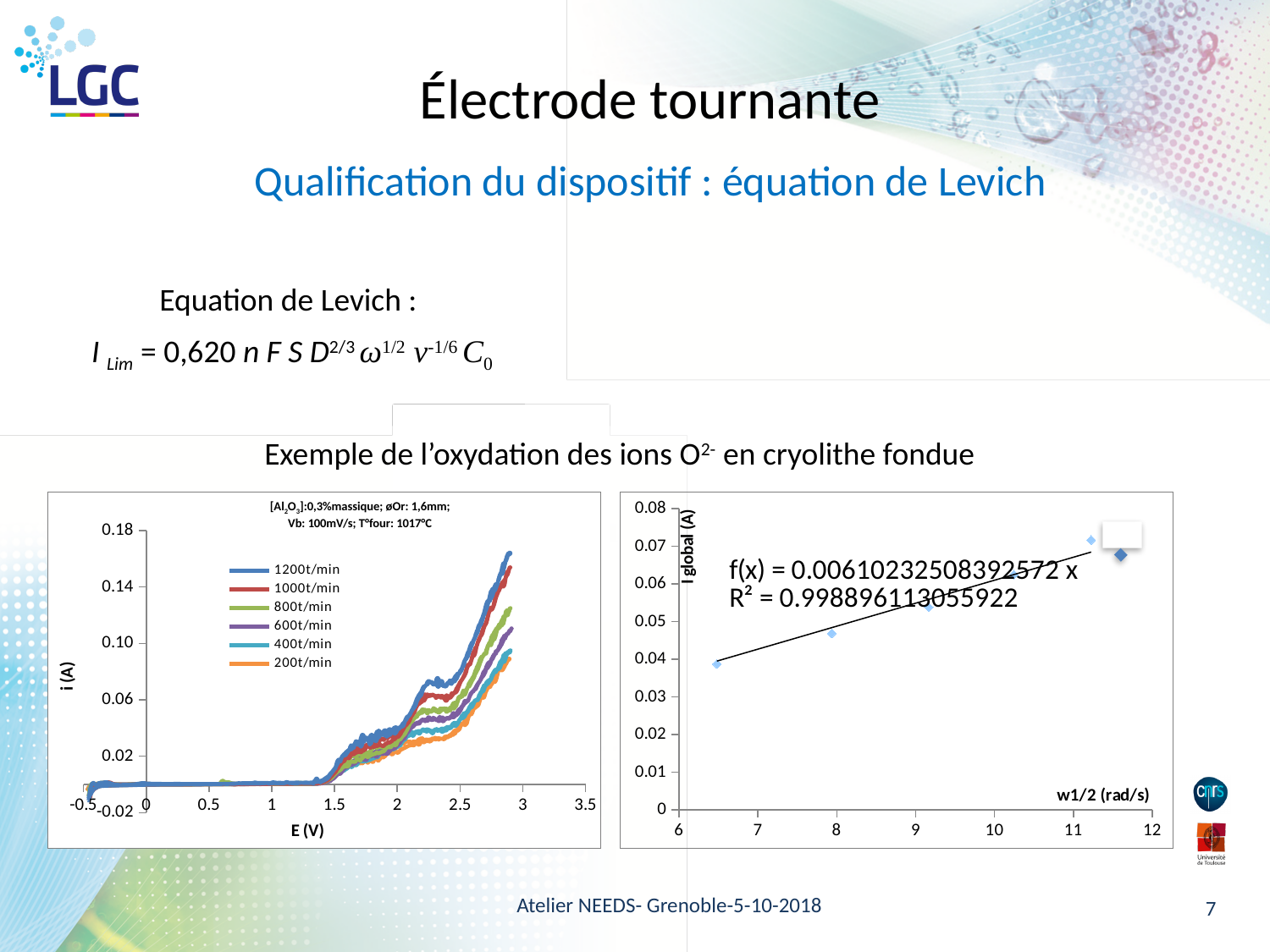
In the right chart, is the I global value of the point near w1/2 = 8 rad/s greater or less than 0.04? greater How many series does the legend of the left chart list? 6 What is the equation of the fitted line shown on the right chart? f(x) = 0.00610232508392572 x In the left chart, which series has the highest current at the right end of the curves (around E = 2.9 V)? 1200t/min What is the x-axis label of the left chart? E (V) In the left chart, is the current of the 200t/min series at E = 2.9 V greater or less than 0.14? less What kind of chart is the left chart (i (A) vs E (V))? line chart In the left chart, do the currents rise or fall as E increases beyond 1.5 V? rise What R² value is shown on the right chart? R² = 0.998896113055922 In the left chart, is the current of the 1200t/min series at E = 2.9 V greater or less than 0.14? greater In the left chart, which series has the lowest current at the right end of the curves (around E = 2.9 V)? 200t/min In the right chart, do the I global values rise or fall as w1/2 increases? rise